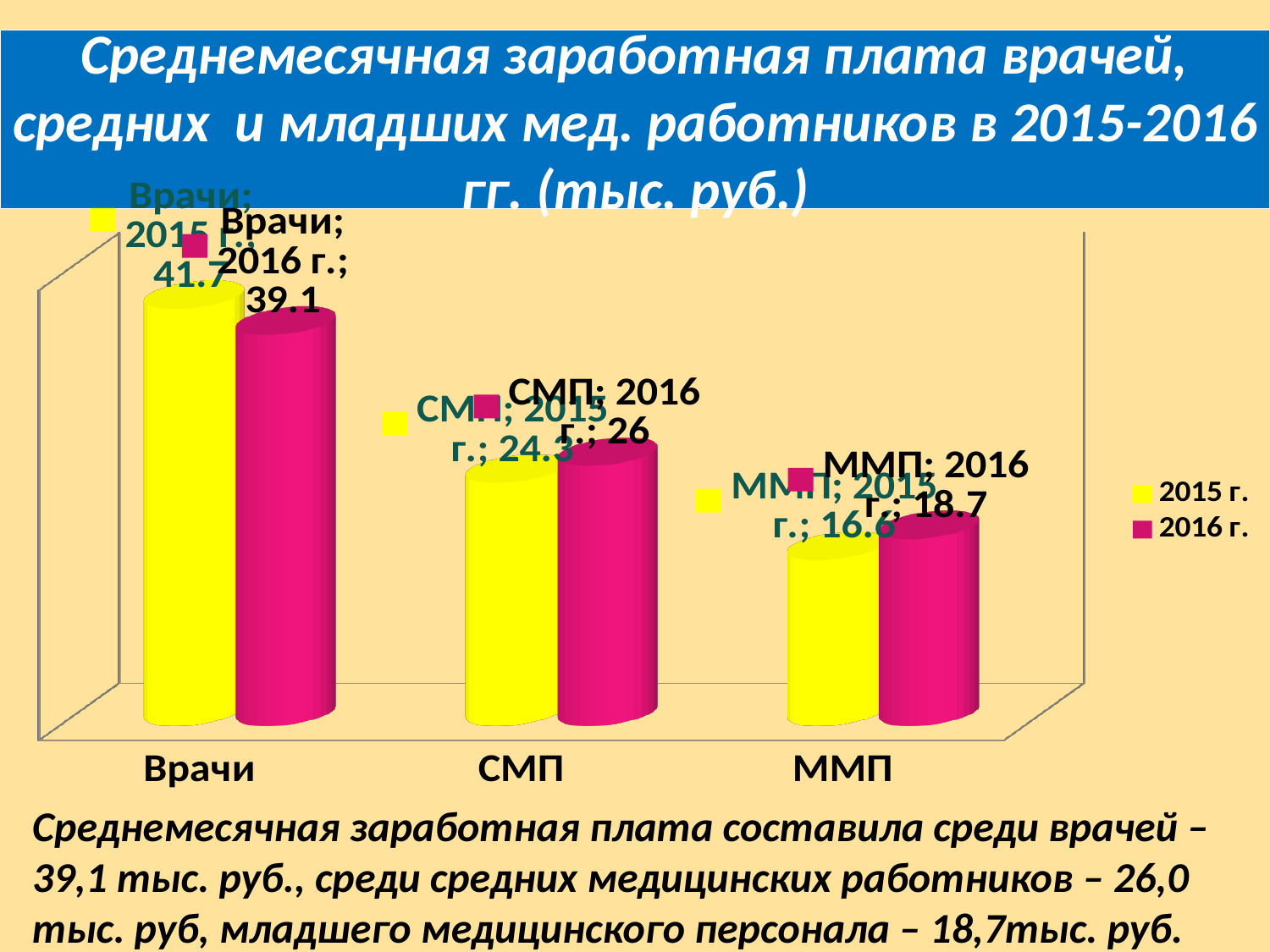
What is the value for ММП in the 2015 г. series? 16.6 What is the value for ММП in the 2016 г. series? 18.7 What is the value for Врачи in the 2015 г. series? 41.7 What is the difference between the 2015 г. and 2016 г. values for Врачи? 2.6 What is the value for СМП in the 2016 г. series? 26 Which category has the lowest value in the 2016 г. series? ММП Which is larger in the 2016 г. series: СМП or ММП? СМП What is the difference between the 2016 г. and 2015 г. values for ММП? 2.1 How many categories are shown on the x axis? 3 How many series does the legend list? 2 Which category has the highest value in the 2015 г. series? Врачи What is the value for Врачи in the 2016 г. series? 39.1